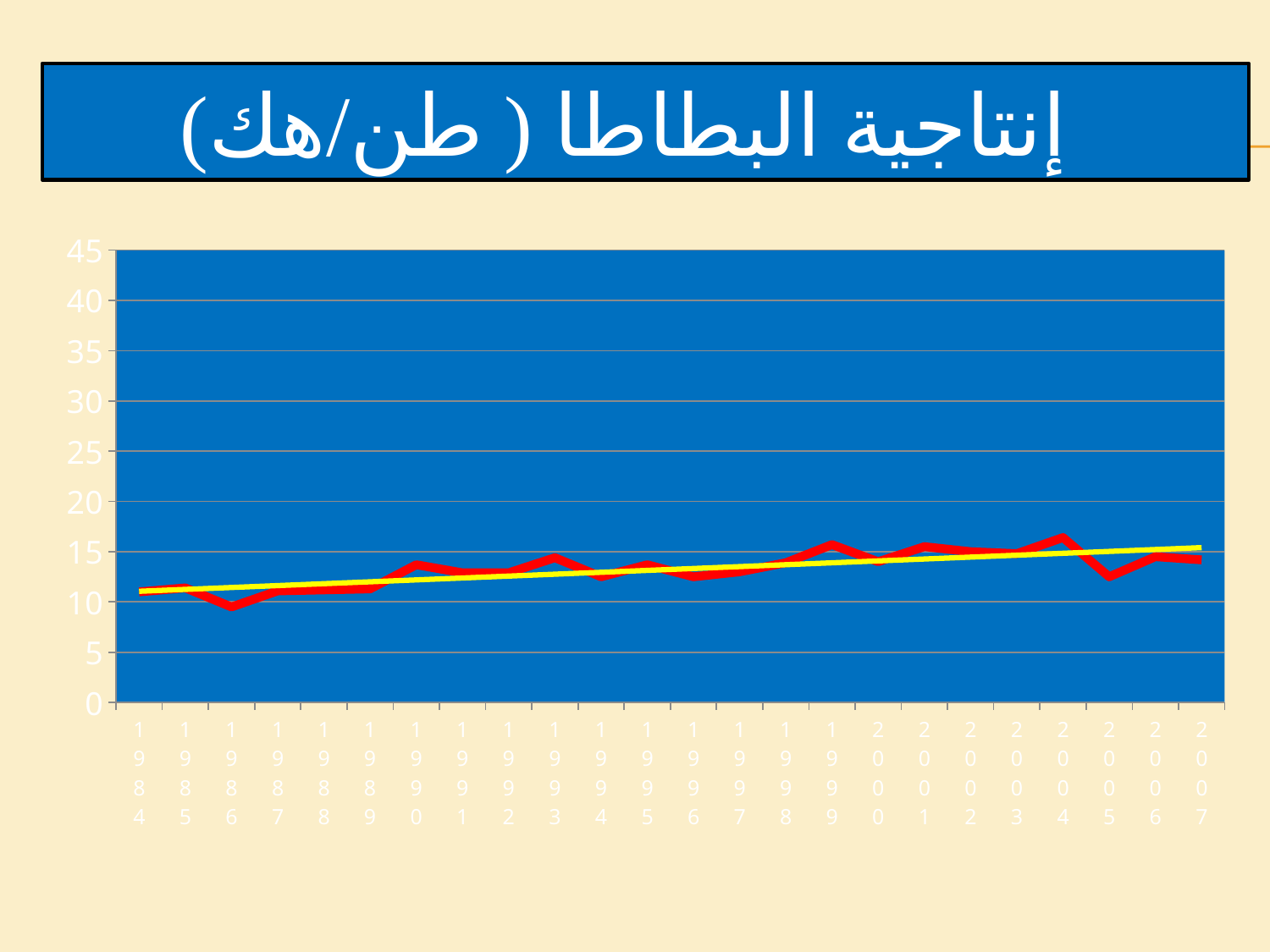
What kind of chart is shown on the slide? line chart Is the value for 1990 greater or less than 10? greater What is the first year shown on the x axis? 1984 How many years (data points) are plotted along the x axis? 24 What is the last year shown on the x axis? 2007 Does the yellow trend line rise or fall from 1984 to 2007? rise Is the value for 2004 greater or less than 20? less Which year has the lowest value on the red line? 1986 What is the highest value shown on the y axis? 45 Is the value for 2005 greater or less than 15? less What is the title of the chart? إنتاجية البطاطا ( طن/هك)